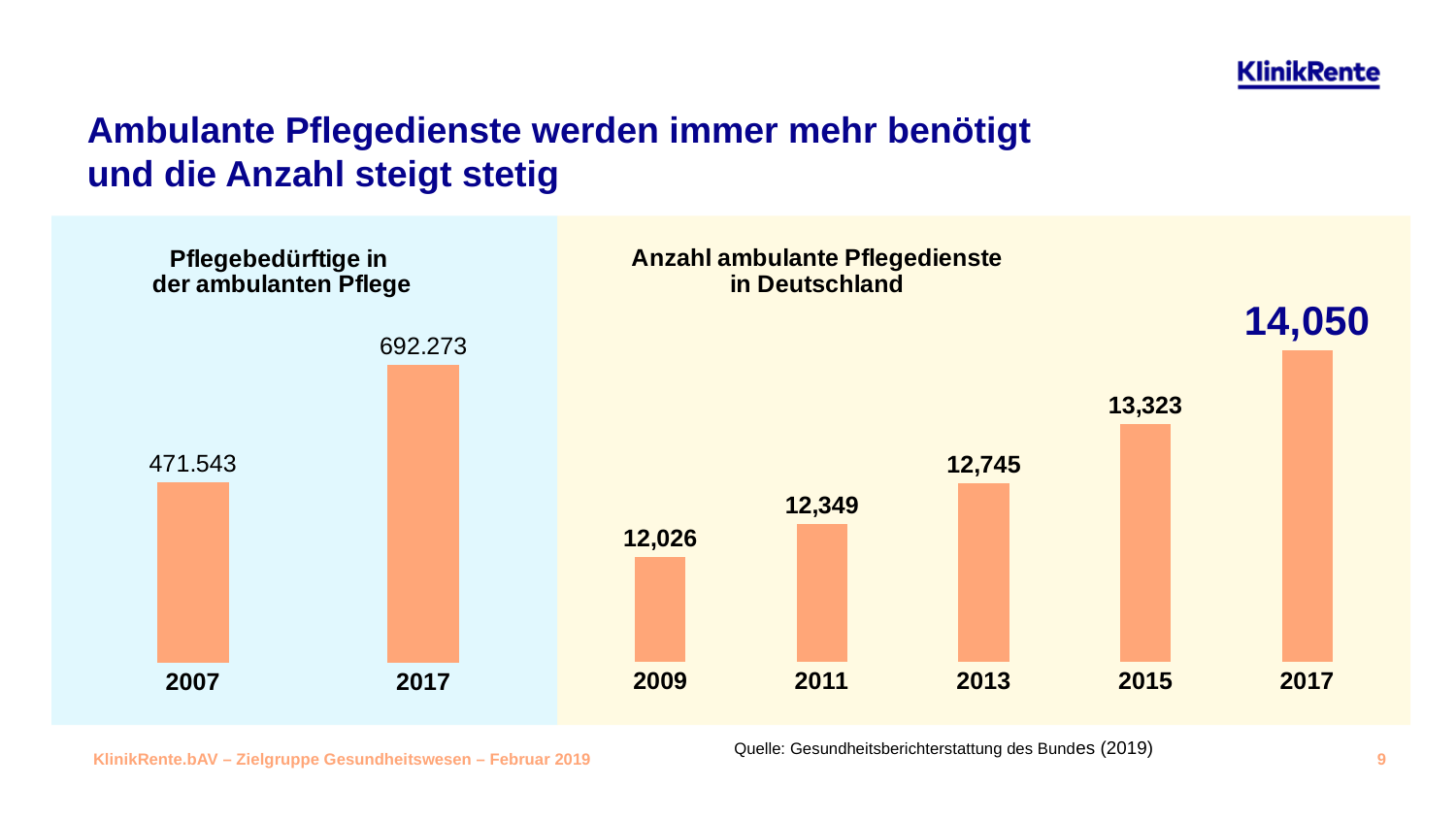
In the chart 'Anzahl ambulante Pflegedienste in Deutschland', what is the difference between the 2017 and 2009 values? 2,024 In the chart 'Anzahl ambulante Pflegedienste in Deutschland', how many years are shown? 5 In the chart 'Pflegebedürftige in der ambulanten Pflege', what is the difference between the 2017 and 2007 values? 220.730 In the chart 'Pflegebedürftige in der ambulanten Pflege', what is the value for 2017? 692.273 In the chart 'Anzahl ambulante Pflegedienste in Deutschland', what is the difference between the 2015 and 2013 values? 578 In the chart 'Anzahl ambulante Pflegedienste in Deutschland', which year has the highest value? 2017 In the chart 'Anzahl ambulante Pflegedienste in Deutschland', do the values rise or fall from 2009 to 2017? rise In the chart 'Anzahl ambulante Pflegedienste in Deutschland', what is the value for 2013? 12,745 What kind of chart is 'Anzahl ambulante Pflegedienste in Deutschland'? bar chart In the chart 'Anzahl ambulante Pflegedienste in Deutschland', which year has the lowest value? 2009 In the chart 'Anzahl ambulante Pflegedienste in Deutschland', what is the value for 2009? 12,026 In the chart 'Pflegebedürftige in der ambulanten Pflege', what is the value for 2007? 471.543